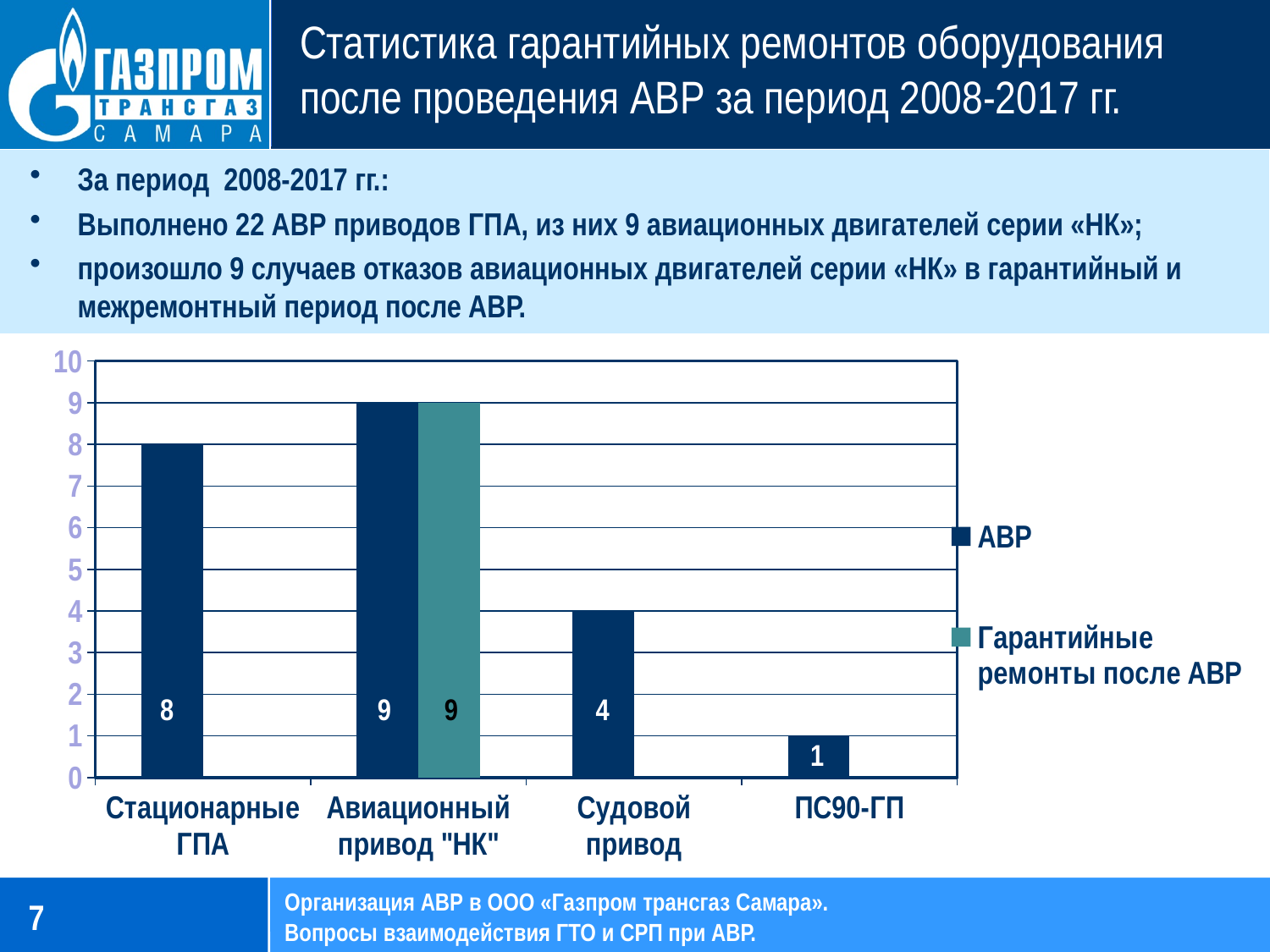
Which category has the lowest АВР value? ПС90-ГП What is the difference between the АВР values for Стационарные ГПА and Судовой привод? 4 Which category has the highest АВР value? Авиационный привод "НК" Which category is the only one with a bar for Гарантийные ремонты после АВР? Авиационный привод "НК" What is the АВР value for ПС90-ГП? 1 How many categories are shown on the x axis? 4 What is the АВР value for Судовой привод? 4 How many series does the legend list? 2 Which is larger: the АВР value for Судовой привод or for ПС90-ГП? Судовой привод What is the АВР value for Стационарные ГПА? 8 What kind of chart is shown on the slide? Bar chart What is the value of Гарантийные ремонты после АВР for Авиационный привод "НК"? 9